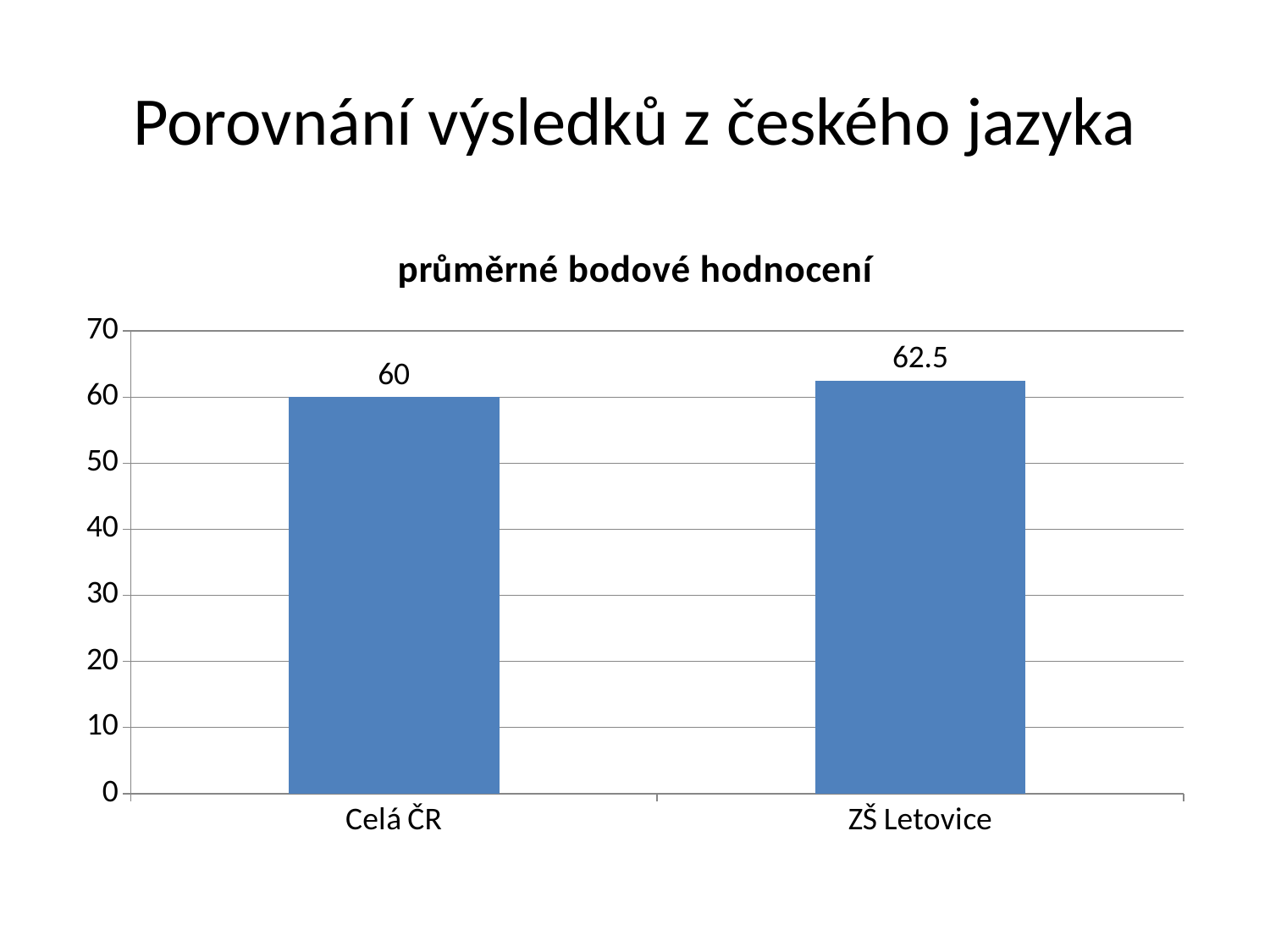
Is the value for ZŠ Letovice greater or less than 70? less What is the value for ZŠ Letovice? 62.5 Is the value for Celá ČR greater or less than 50? greater What is the difference between the values for ZŠ Letovice and Celá ČR? 2.5 How many categories are shown in the chart? 2 What is the highest value shown on the vertical axis? 70 What is the value for Celá ČR? 60 Which is larger, the value for Celá ČR or the value for ZŠ Letovice? ZŠ Letovice What is the title of the chart? průměrné bodové hodnocení Which category has the highest value? ZŠ Letovice What kind of chart is shown on the slide? bar chart Which category has the lowest value? Celá ČR